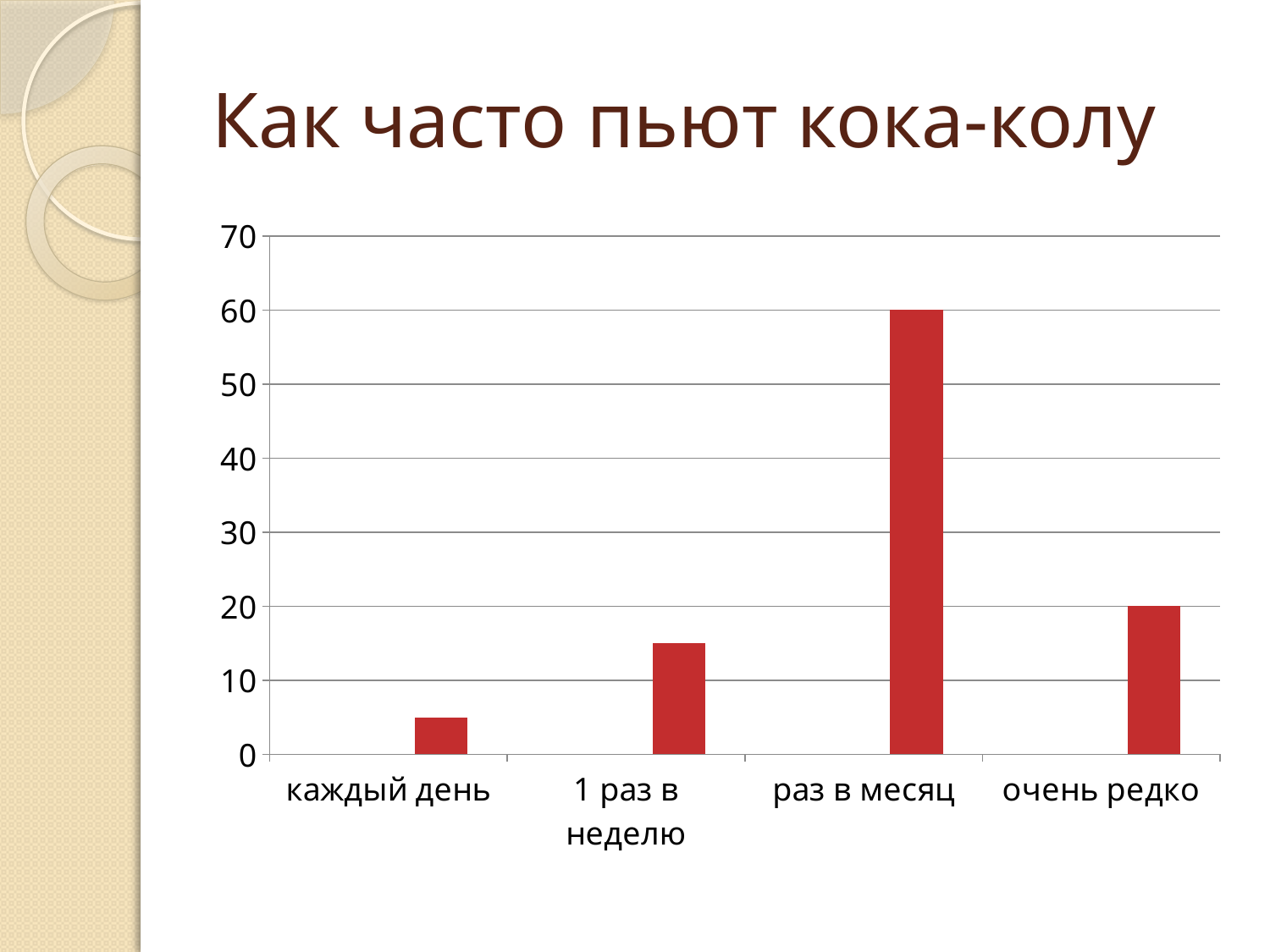
Is the value for "каждый день" greater or less than 10? less What kind of chart is shown on the slide? bar chart How many categories are shown on the x axis? 4 What is the title of the chart? Как часто пьют кока-колу Which category has the lowest value? каждый день What colour are the bars in the chart? red Is the value for "1 раз в неделю" greater or less than 10? greater Which category has the highest value? раз в месяц What is the value for "раз в месяц"? 60 What is the value for "очень редко"? 20 Which is larger, the value for "1 раз в неделю" or the value for "очень редко"? очень редко What is the difference between the values for "раз в месяц" and "очень редко"? 40